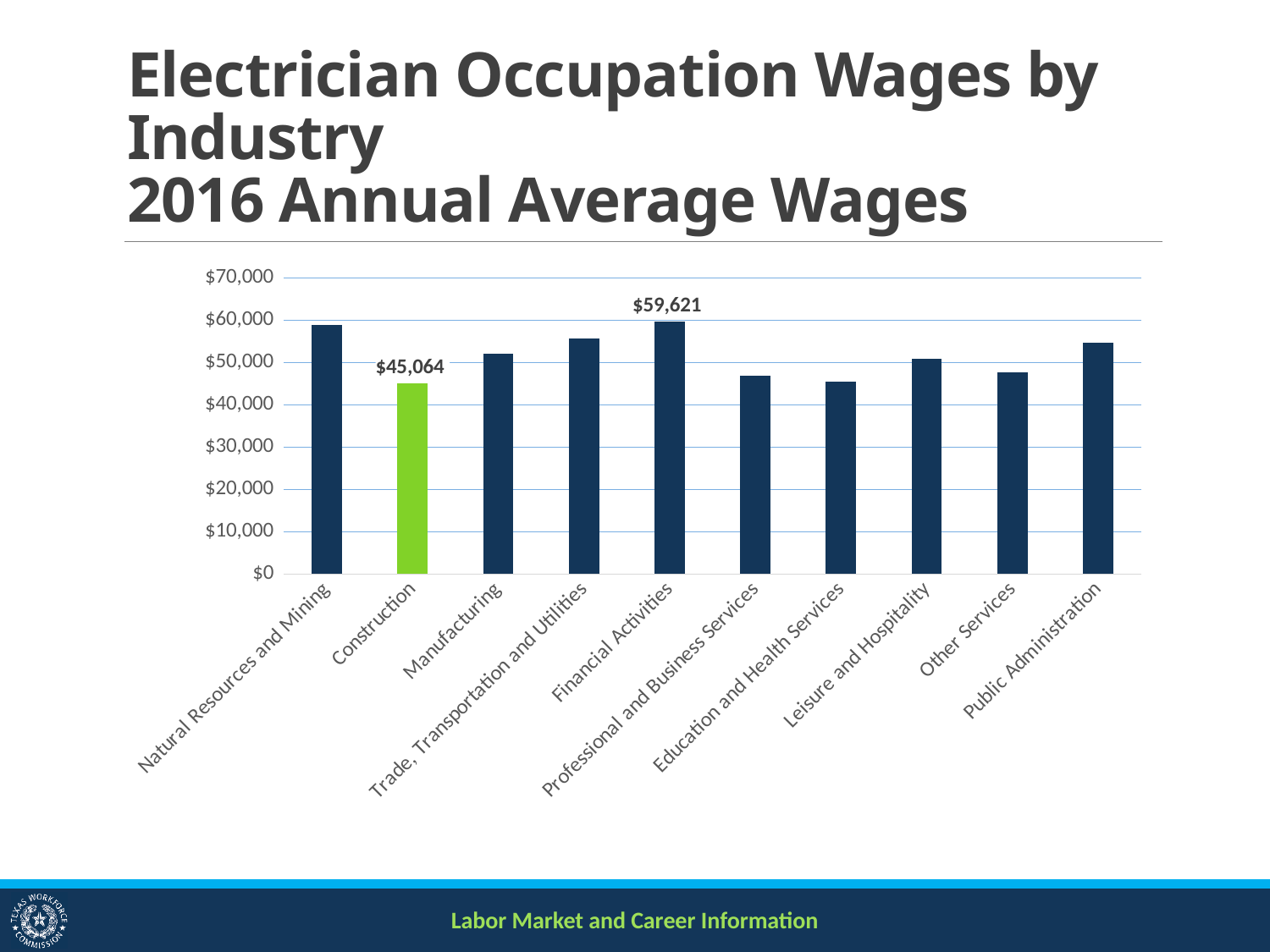
What kind of chart is shown on the slide? bar chart Is the value for Professional and Business Services greater or less than $50,000? less What is the difference between the Financial Activities wage and the Construction wage? $14,557 How many industries are shown on the chart? 10 Which is larger, the wage for Construction or the wage for Financial Activities? Financial Activities Is the value for Public Administration greater or less than $50,000? greater Is the value for Manufacturing greater or less than $50,000? greater What is the 2016 annual average wage for electricians in Financial Activities? $59,621 Which is larger, the wage for Manufacturing or the wage for Professional and Business Services? Manufacturing What is the 2016 annual average wage for electricians in Construction? $45,064 Which industry's bar is highlighted in green? Construction